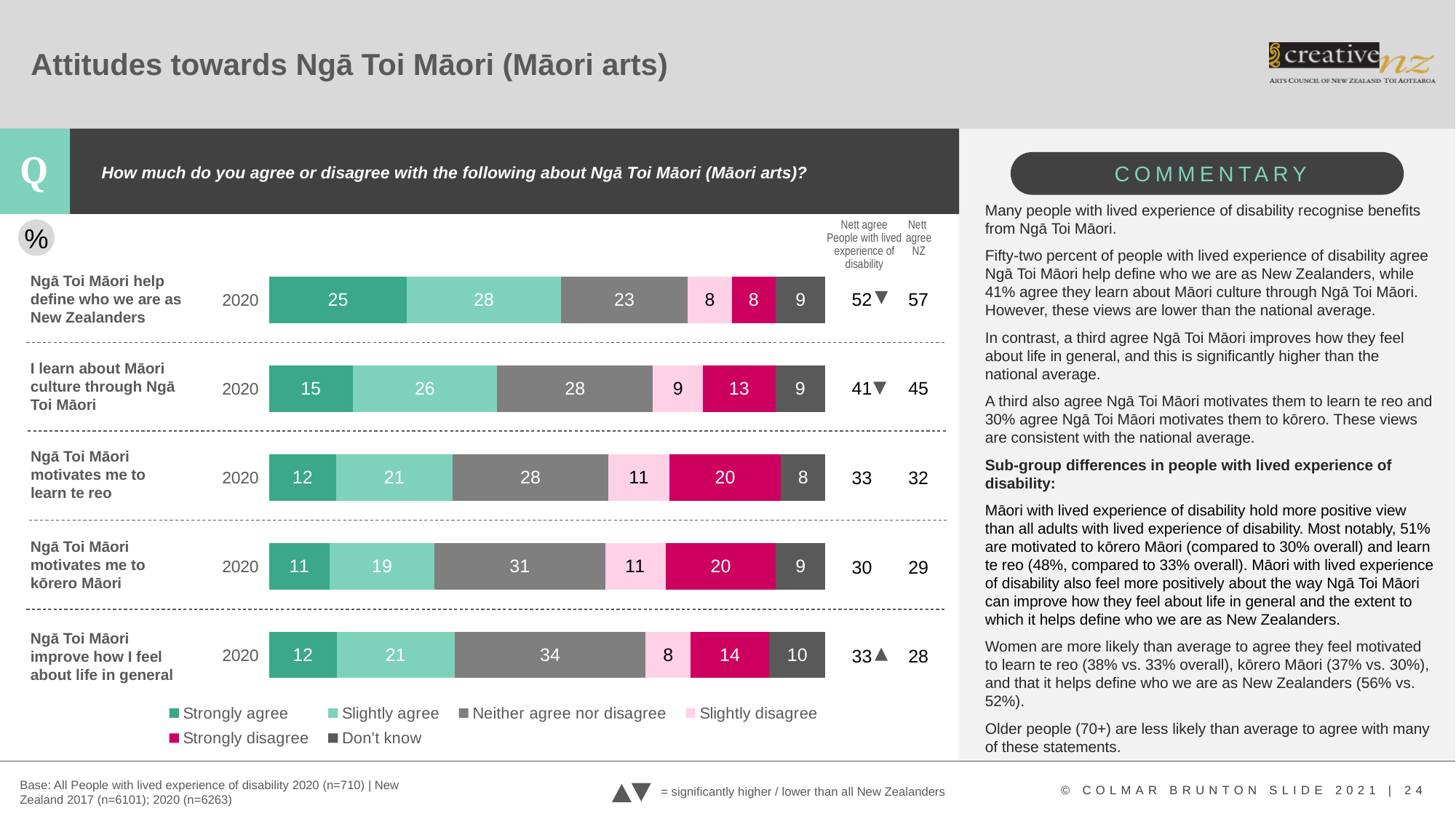
How many series does the legend list? 6 What is the 'Neither agree nor disagree' value for the statement 'Ngā Toi Māori improve how I feel about life in general'? 34 What percentage of people strongly agree that Ngā Toi Māori help define who we are as New Zealanders? 25 What is the combined 'Strongly agree' and 'Slightly agree' total for 'Ngā Toi Māori motivates me to learn te reo'? 33 How many statements are shown in the chart? 5 What is the 'Strongly disagree' value for 'I learn about Māori culture through Ngā Toi Māori'? 13 Which statement has the highest 'Strongly agree' value? Ngā Toi Māori help define who we are as New Zealanders What colour represents 'Strongly disagree' in the legend? Magenta/pink-red Is the 'Strongly disagree' value larger for 'Ngā Toi Māori motivates me to learn te reo' or for 'Ngā Toi Māori improve how I feel about life in general'? Ngā Toi Māori motivates me to learn te reo What is the difference between the 'Slightly agree' values for 'Ngā Toi Māori help define who we are as New Zealanders' and 'Ngā Toi Māori motivates me to kōrero Māori'? 9 What kind of chart is shown on the slide? Stacked bar chart Which statement has the lowest 'Strongly agree' value? Ngā Toi Māori motivates me to kōrero Māori